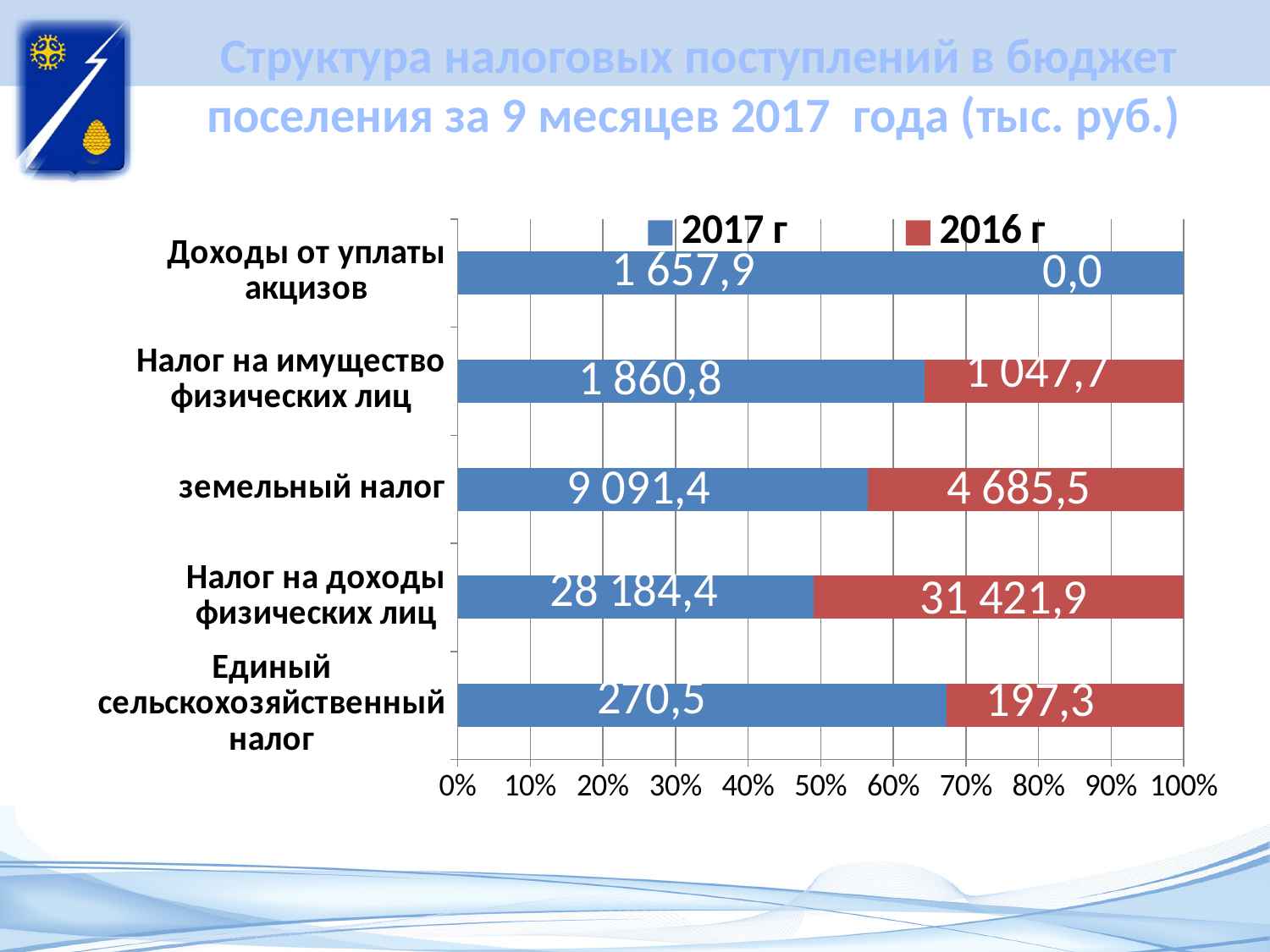
What type of chart is shown on the slide? Bar chart How many series does the legend list? 2 How many tax categories are shown on the chart? 5 What is the 2016 г value for Доходы от уплаты акцизов? 0,0 By how much does the 2017 г value for земельный налог exceed the 2016 г value? 4 405,9 For Налог на доходы физических лиц, which year has the larger value, 2017 г or 2016 г? 2016 г Which category has the highest 2017 г value? Налог на доходы физических лиц What is the 2017 г value for Единый сельскохозяйственный налог? 270,5 What is the 2017 г value for земельный налог? 9 091,4 What is the difference between the 2017 г and 2016 г values for Единый сельскохозяйственный налог? 73,2 Which category has the lowest 2016 г value? Доходы от уплаты акцизов What is the 2016 г value for Налог на доходы физических лиц? 31 421,9